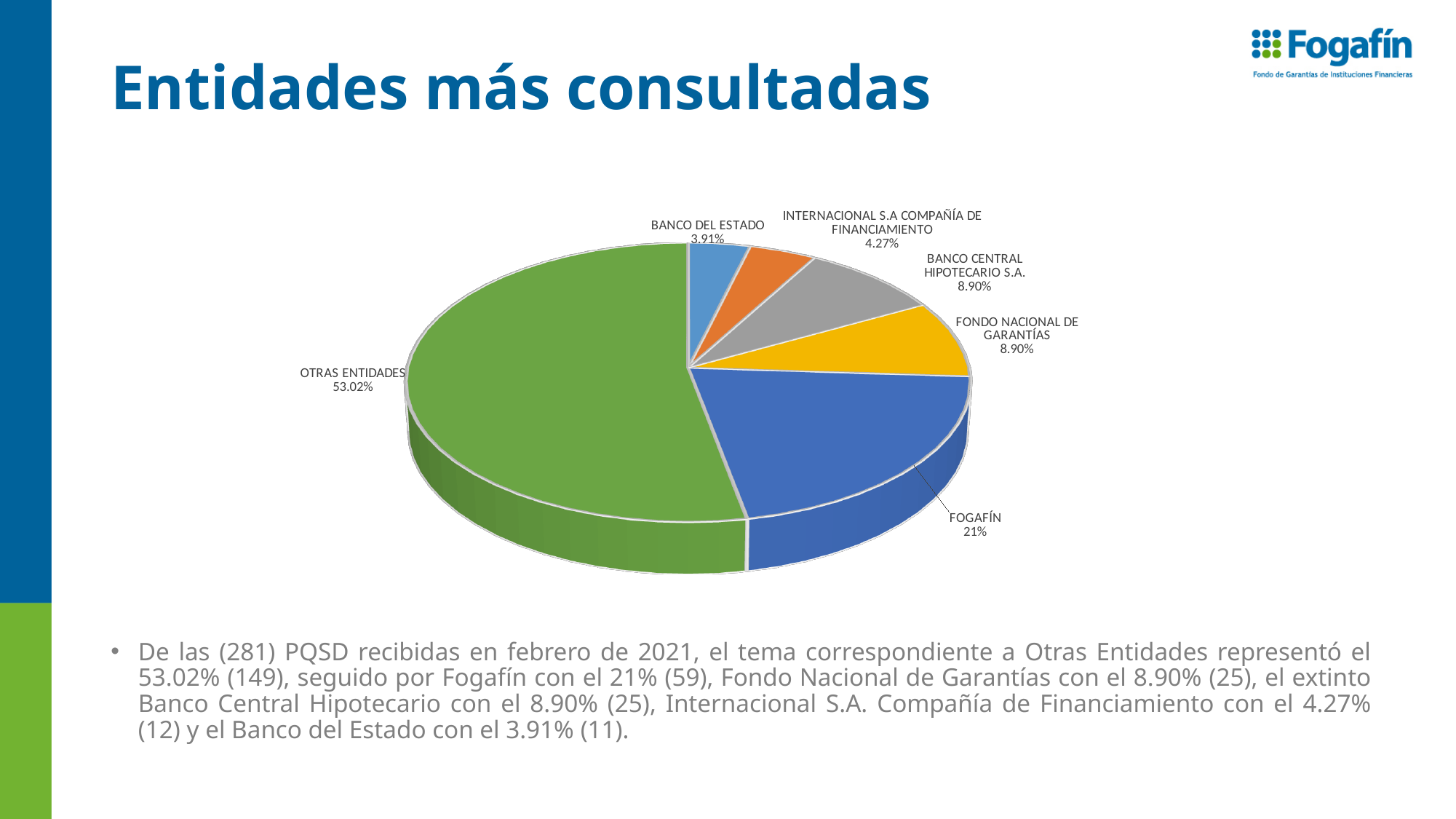
What is the value shown for FOGAFÍN? 21% What colour is the OTRAS ENTIDADES slice? Green What is the difference between the OTRAS ENTIDADES share and the FOGAFÍN share? 32.02% What share of the pie does OTRAS ENTIDADES represent? 53.02% Which is larger, the share for INTERNACIONAL S.A COMPAÑÍA DE FINANCIAMIENTO or the share for BANCO DEL ESTADO? INTERNACIONAL S.A COMPAÑÍA DE FINANCIAMIENTO What is the value shown for INTERNACIONAL S.A COMPAÑÍA DE FINANCIAMIENTO? 4.27% What kind of chart is shown on the slide? Pie chart What is the value shown for BANCO DEL ESTADO? 3.91% How many slices does the pie chart have? 6 What is the value shown for FONDO NACIONAL DE GARANTÍAS? 8.90% Which category has the smallest slice of the pie? BANCO DEL ESTADO Which category has the largest slice of the pie? OTRAS ENTIDADES